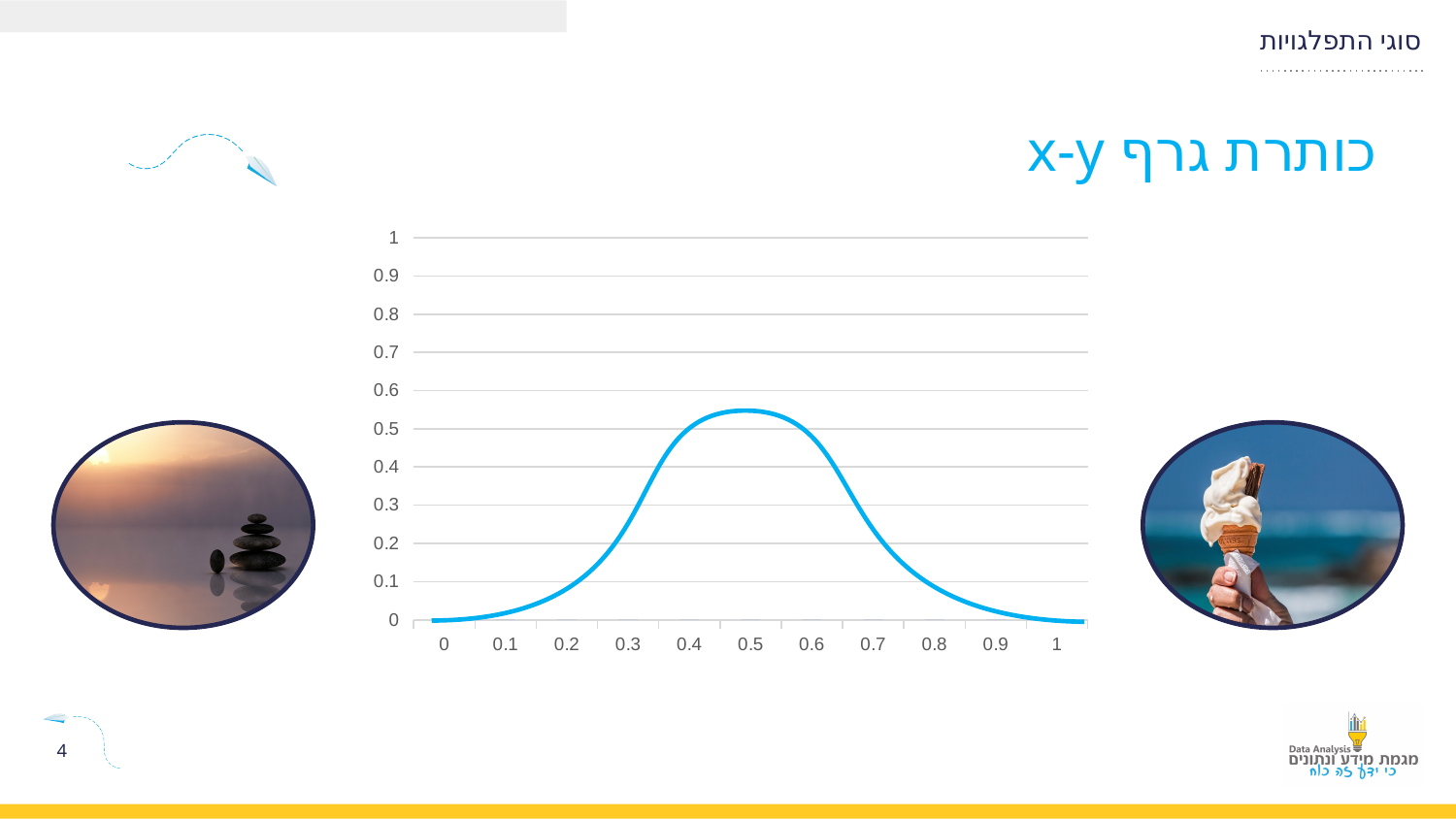
Does the curve rise or fall as x goes from 0.5 to 1? fall Is the value of the curve at x = 0.4 greater or less than 0.3? greater What kind of chart is shown on the slide? line chart Around which x-axis tick does the curve reach its highest value? 0.5 Is the value of the curve at x = 0.8 greater or less than 0.2? less Is the value of the curve at x = 0.2 greater or less than 0.2? less How many tick labels are shown on the x axis? 11 Does the curve rise or fall as x goes from 0 to 0.5? rise Which is larger, the value of the curve at x = 0.5 or at x = 0.9? x = 0.5 What is the highest value labelled on the y axis? 1